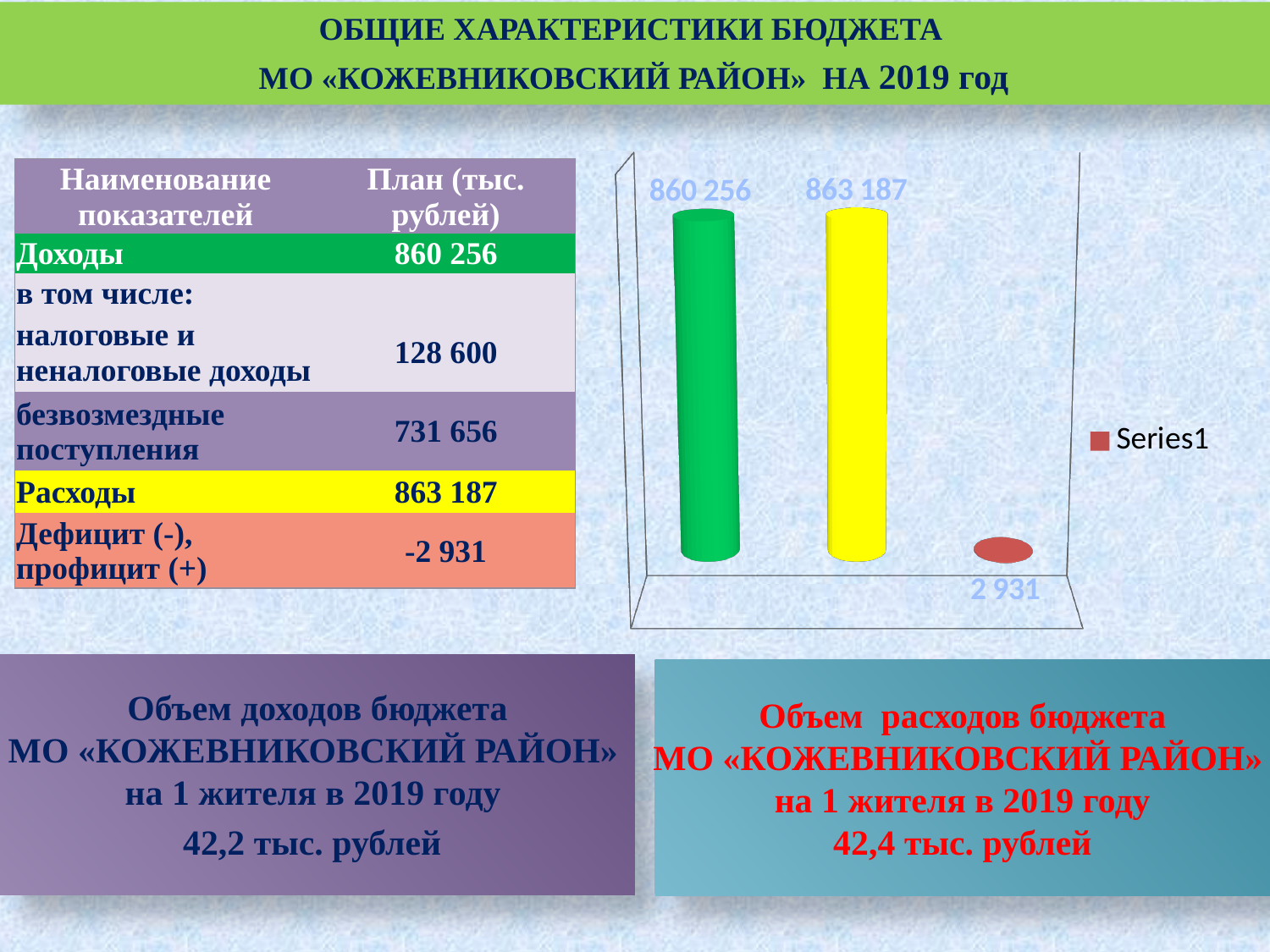
How many series does the chart legend list? 1 Is the value of the yellow bar larger or smaller than the value of the green bar? Larger What value is labelled on the small red bar in the chart? 2 931 What value is labelled on the green bar in the chart? 860 256 What is the name of the series shown in the chart legend? Series1 How many bars are plotted in the chart? 3 What kind of chart is shown on the slide? Bar chart What is the difference between the yellow bar (863 187) and the green bar (860 256)? 2 931 Which bar in the chart has the highest value? The yellow bar (863 187) What value is labelled on the yellow bar in the chart? 863 187 What colour is the bar labelled 860 256? Green Which bar in the chart has the lowest value? The red bar (2 931)